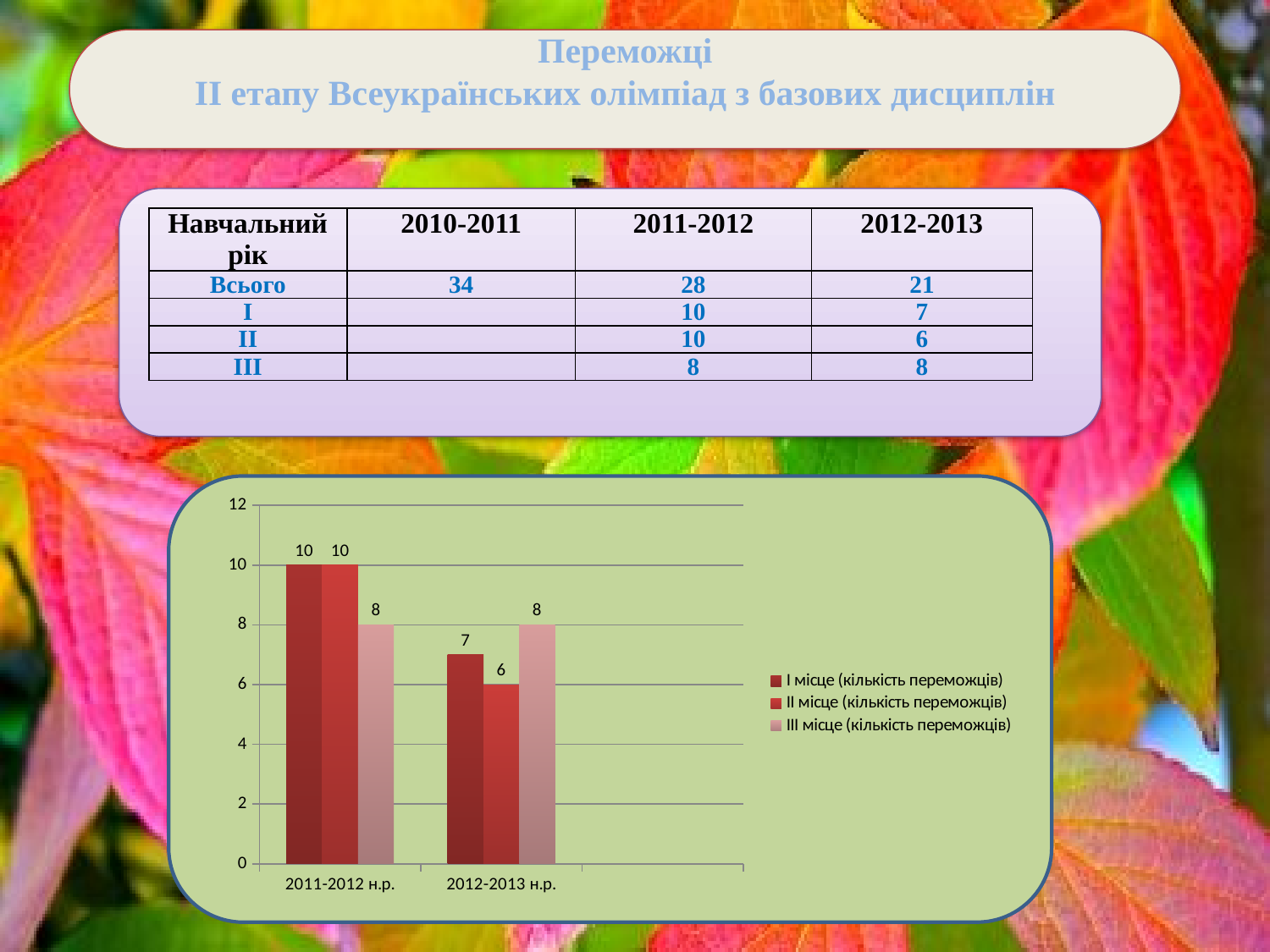
Does the value for I місце (кількість переможців) rise or fall from 2011-2012 н.р. to 2012-2013 н.р.? fall Which is larger: the II місце value in 2011-2012 н.р. or in 2012-2013 н.р.? 2011-2012 н.р. Which series has the lowest value in 2012-2013 н.р.? II місце (кількість переможців) What type of chart is shown on the slide? bar chart What is the value for I місце (кількість переможців) in 2011-2012 н.р.? 10 What is the value for III місце (кількість переможців) in 2012-2013 н.р.? 8 What is the difference between the I місце and III місце values in 2011-2012 н.р.? 2 What is the value for II місце (кількість переможців) in 2012-2013 н.р.? 6 How many categories are shown on the x axis of the chart? 2 How many series does the chart legend list? 3 Which series has the highest value in 2012-2013 н.р.? III місце (кількість переможців) What is the difference between the I місце values for 2011-2012 н.р. and 2012-2013 н.р.? 3